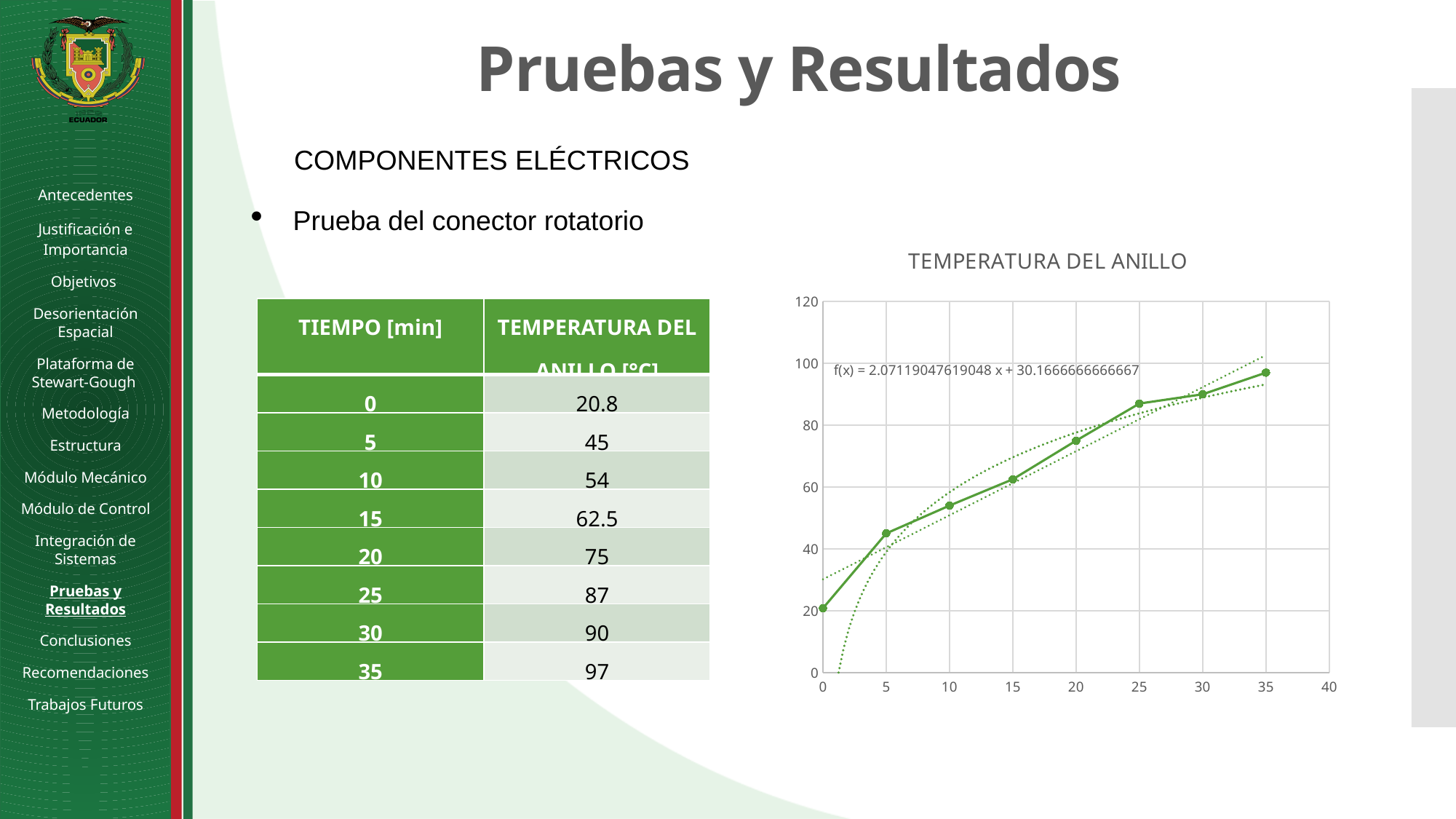
What is the ring temperature at 20 minutes? 75 What kind of chart is shown on the slide? line chart Which is larger, the ring temperature at 15 minutes or at 25 minutes? 25 minutes What is the title of the chart? TEMPERATURA DEL ANILLO Is the plotted value at 20 minutes greater or less than 60? greater At which time (in minutes) is the ring temperature highest? 35 What is the trendline equation displayed on the chart? f(x) = 2.07119047619048 x + 30.1666666666667 How many data points are plotted on the line in the chart? 8 At which time (in minutes) is the ring temperature lowest? 0 What is the ring temperature at 0 minutes? 20.8 What is the difference between the ring temperature at 35 minutes and at 0 minutes? 76.2 Do the plotted temperature values rise or fall as time increases along the x axis? rise